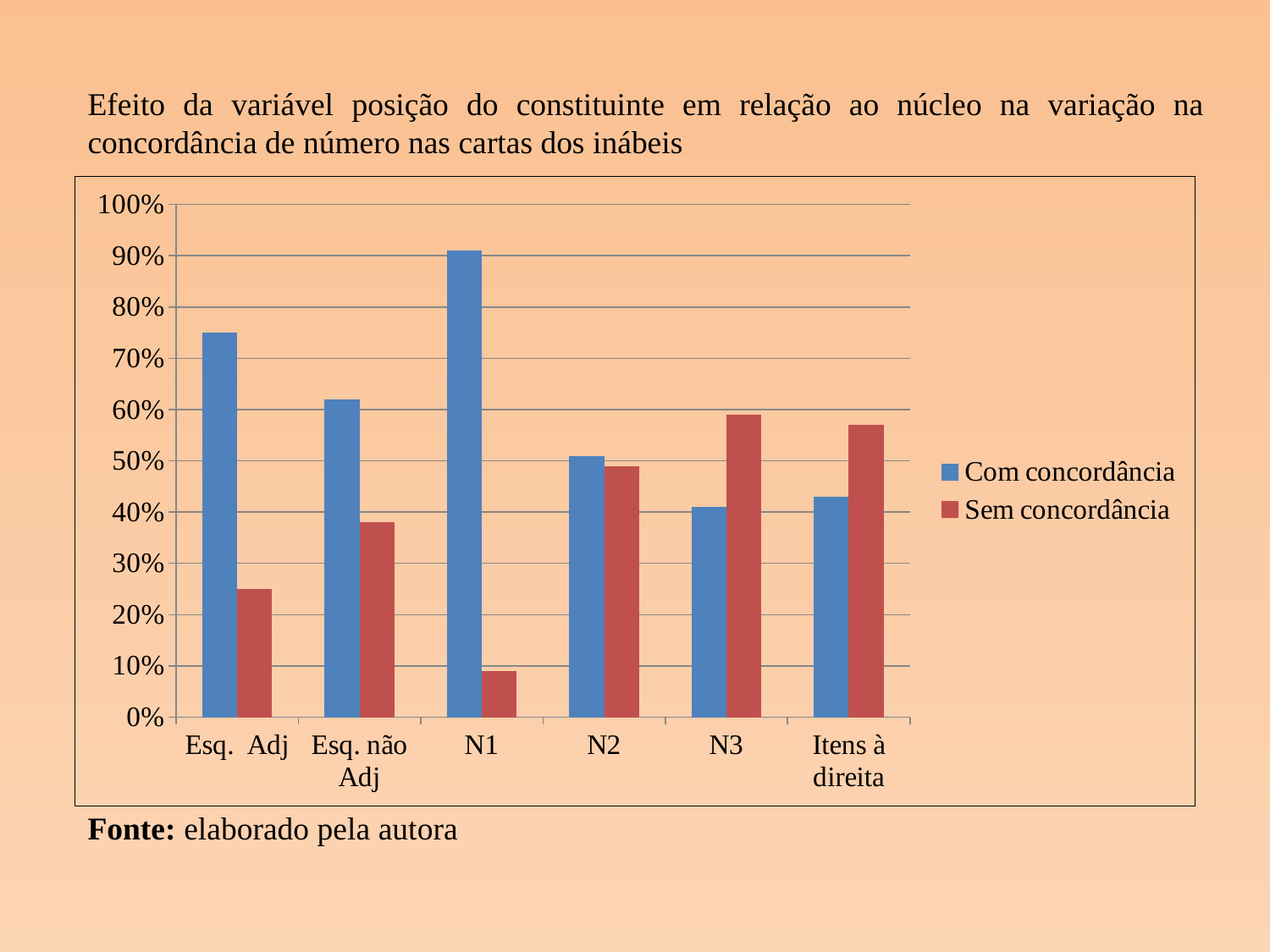
Is the value for Com concordância at Esq. não Adj greater or less than 50%? greater How many categories are shown on the x axis? 6 For Esq. Adj, which series has the larger value, Com concordância or Sem concordância? Com concordância What kind of chart is shown on the slide? bar chart For N3, which series has the larger value, Com concordância or Sem concordância? Sem concordância How many series does the legend list? 2 Which category has the highest value for Com concordância? N1 Is the value for Sem concordância at Esq. Adj greater or less than 30%? less Which colour represents the Com concordância series? blue Is the value for Sem concordância at N3 greater or less than 50%? greater Which category has the lowest value for Sem concordância? N1